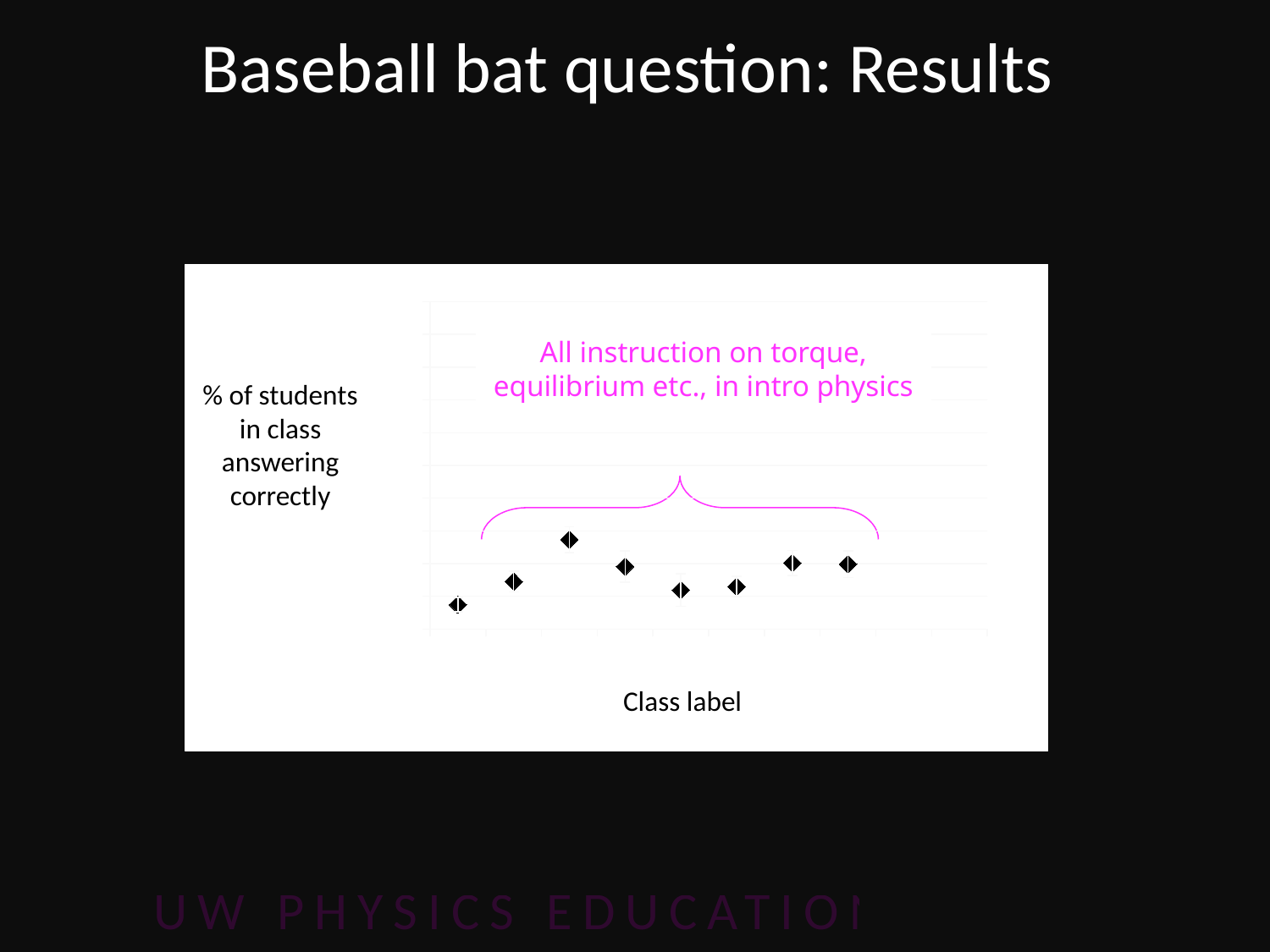
What kind of chart is shown on the slide? scatter chart Counting from the left, which point on the chart has the highest value? the third point What is the label on the vertical axis of the chart? % of students in class answering correctly What is the label on the horizontal axis of the chart? Class label Counting from the left, which point on the chart has the lowest value? the first point How many data points are plotted on the chart? 8 Which plotted point is the lowest: the first from the left or the last on the right? the first from the left Which plotted point is the highest: the first from the left or the third from the left? the third from the left